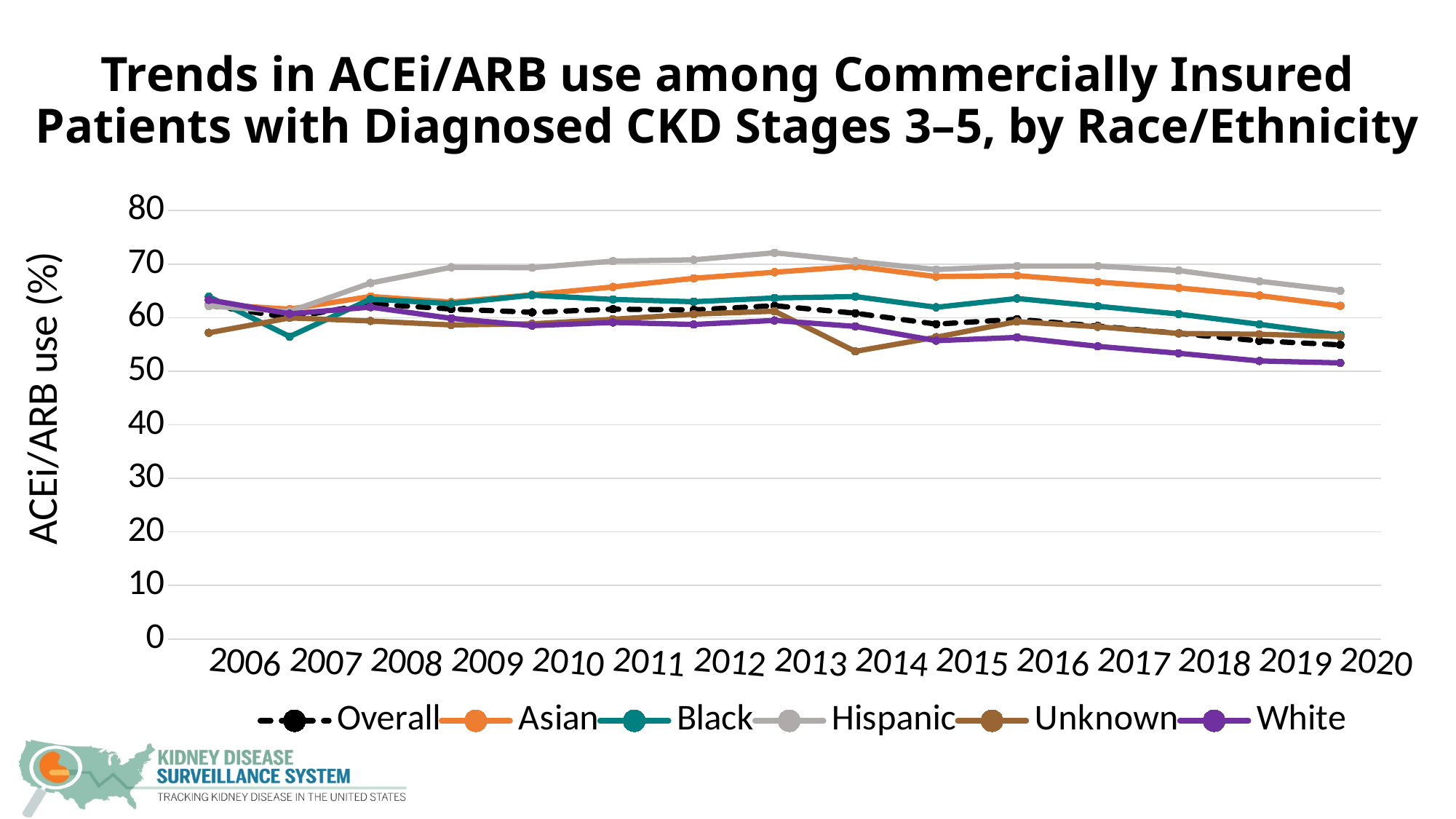
Which series has the lowest ACEi/ARB use in 2020? White Is the value for Hispanic in 2013 greater or less than 70? greater Is the value for Unknown in 2014 greater or less than 60? less How many series does the legend list? 6 What kind of chart is shown on the slide? line chart In 2020, which is larger: the value for Hispanic or the value for White? Hispanic How many years are shown along the x axis? 15 Is the value for Asian in 2014 greater or less than 60? greater Which series has the highest ACEi/ARB use in 2013? Hispanic Does the White series rise or fall from 2013 to 2020? fall What is the label on the y axis? ACEi/ARB use (%)